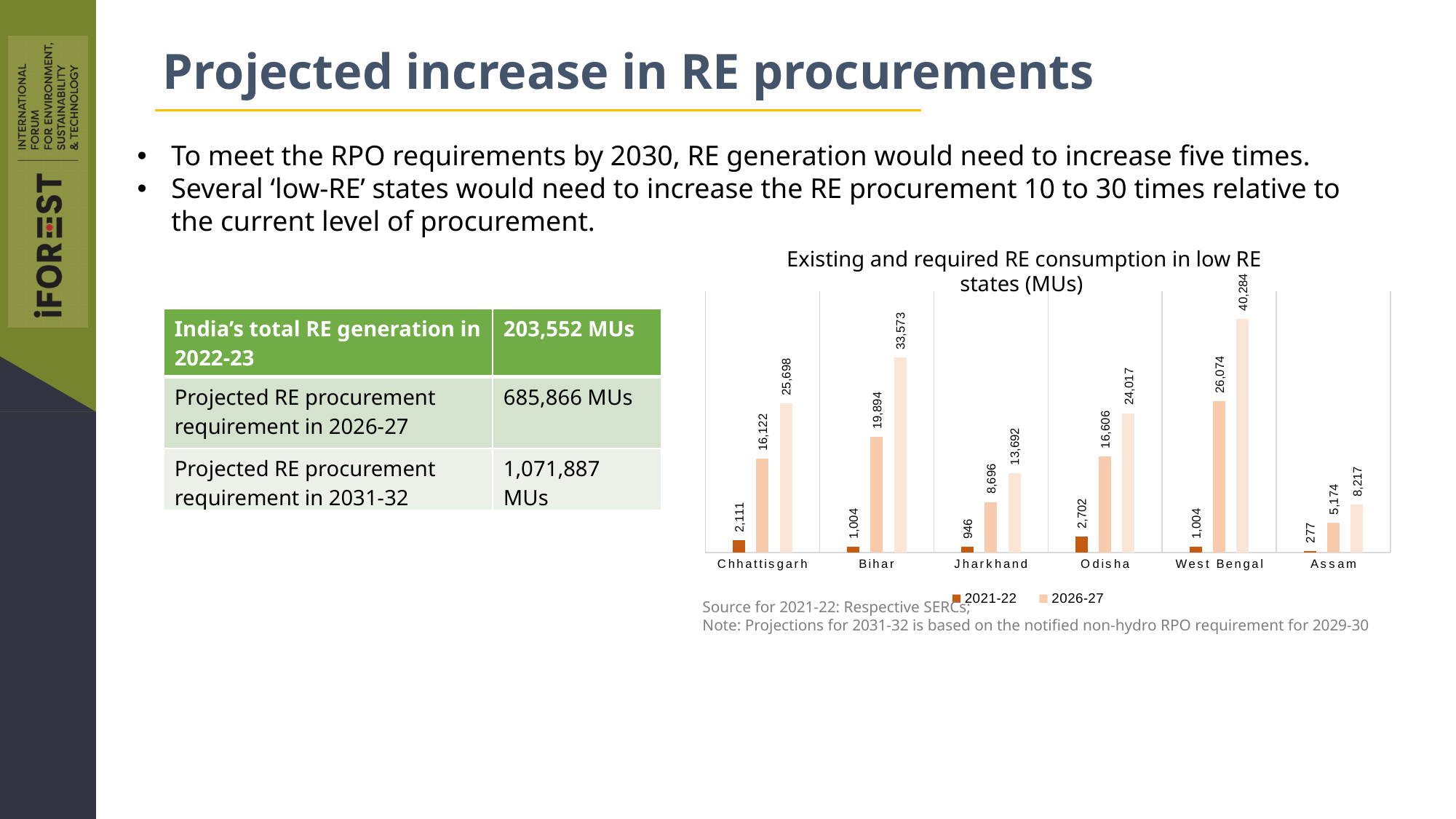
Which state has the lowest 2021-22 value? Assam What type of chart is used to show existing and required RE consumption? Bar chart What is the 2021-22 RE consumption value shown for Odisha? 2,702 Which has the larger 2026-27 value, Chhattisgarh or Odisha? Odisha What is the difference between the 2026-27 and 2021-22 values for Chhattisgarh? 14,011 What is the 2021-22 value shown for Jharkhand? 946 What is the difference between the 2026-27 and 2021-22 values for Assam? 4,897 How many states are shown on the x axis of the chart? 6 What is the value of the tallest (lightest-coloured) bar for West Bengal? 40,284 Which state has the highest 2026-27 value? West Bengal Which state has the highest 2021-22 value? Odisha What is the 2026-27 value shown for Bihar? 19,894